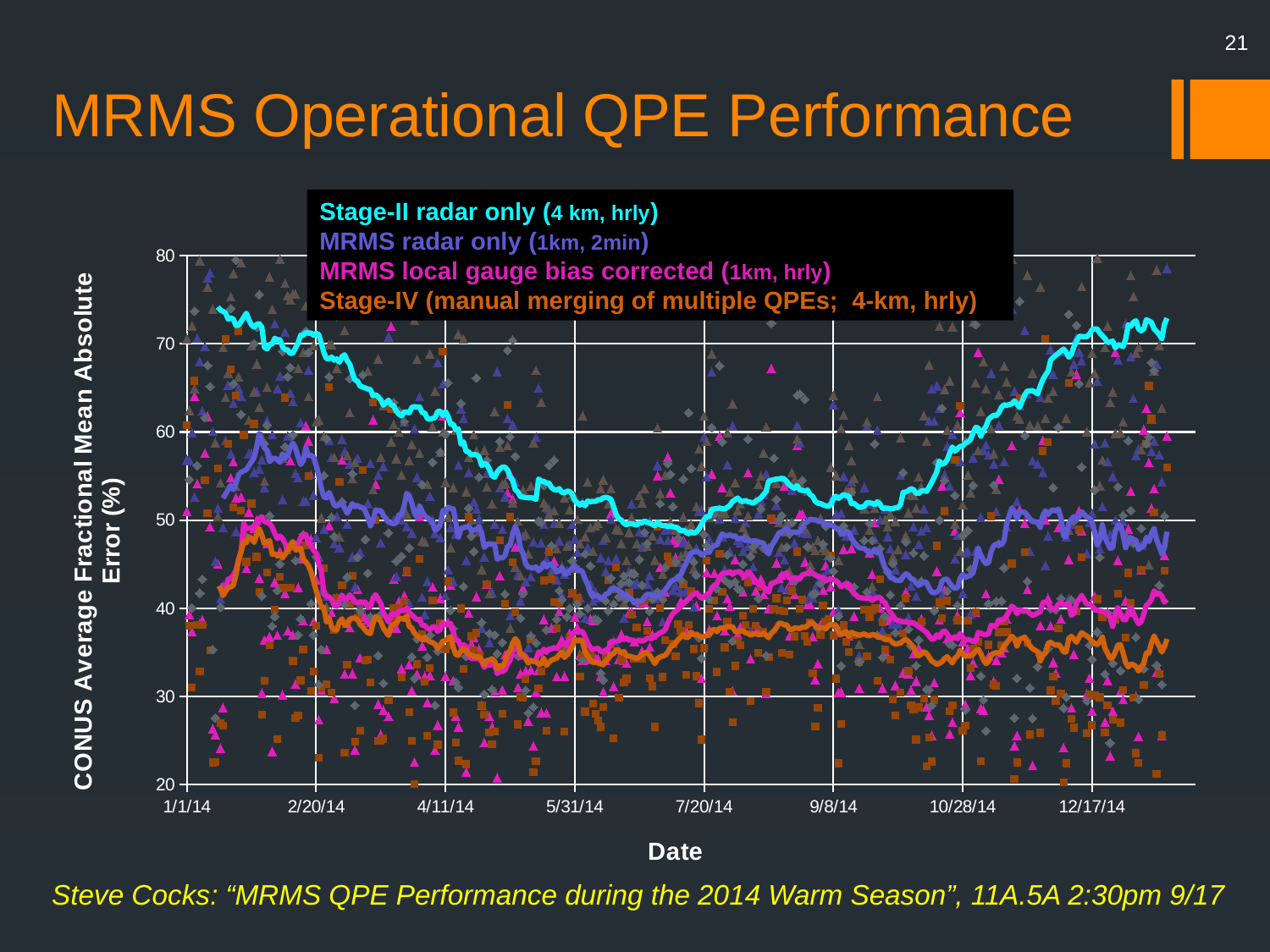
Which series is drawn in cyan? Stage-II radar only At 4/11/14, which series has the higher value: Stage-II radar only or Stage-IV? Stage-II radar only Is the Stage-IV value at 5/31/14 greater or less than 40? less Does the Stage-II radar only line rise or fall between 9/8/14 and 12/17/14? rise What is the label of the x axis? Date Is the Stage-II radar only value at 4/11/14 greater or less than 60? greater How many series does the legend list? 4 Is the MRMS radar only value at 2/20/14 greater or less than 50? greater Does the Stage-II radar only line rise or fall between 1/1/14 and 7/20/14? fall What kind of chart is shown on the slide? Line chart with scatter points At 10/28/14, which series has the higher value: MRMS radar only or Stage-IV? MRMS radar only